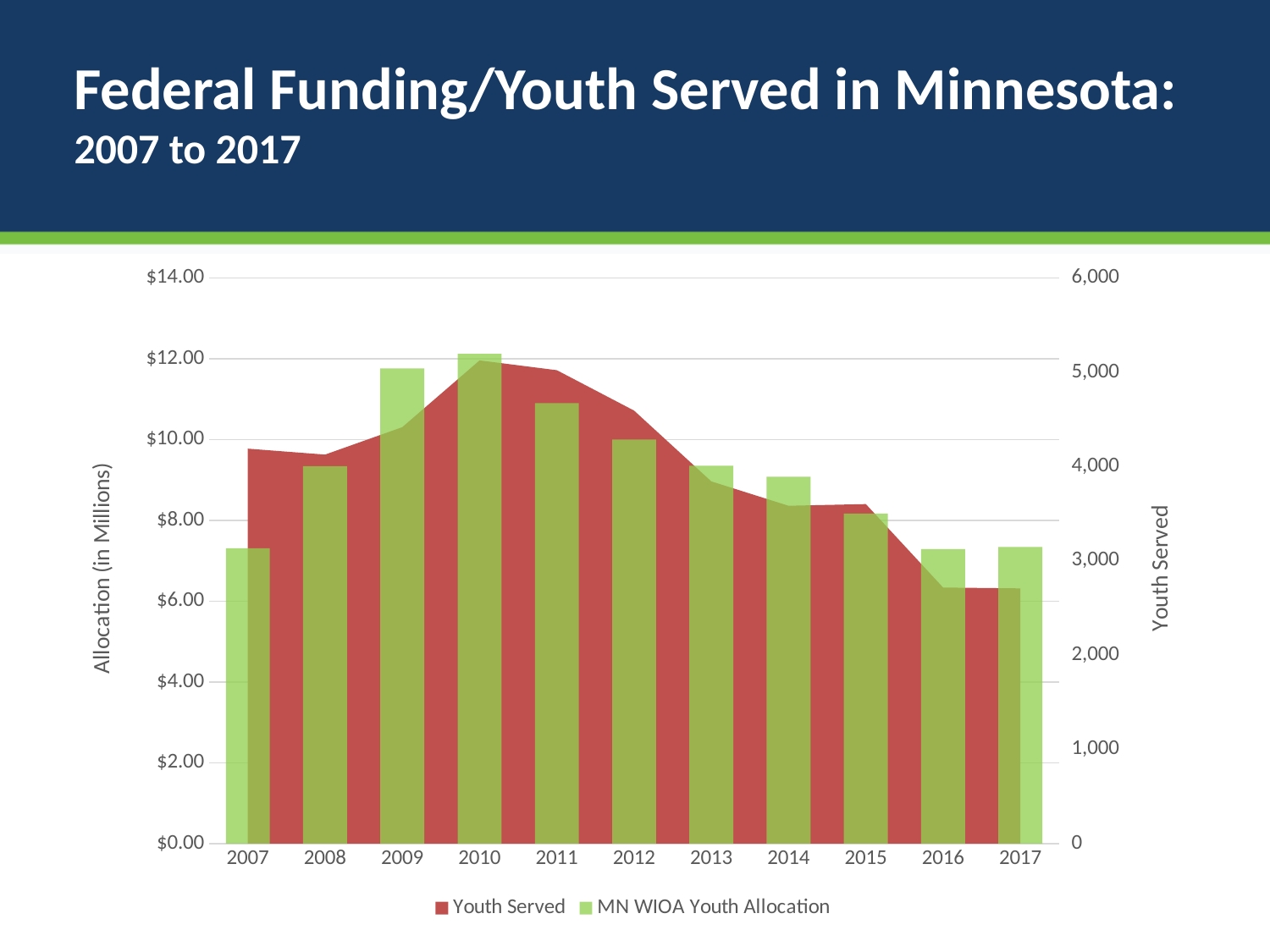
How many years are shown along the x axis of the chart? 11 Does the number of Youth Served rise or fall from 2010 to 2017? fall What kind of chart is shown on the slide? A combination of a bar chart and an area chart Is the number of Youth Served in 2016 greater or less than 3,000? less How many series does the chart's legend list? 2 Is the MN WIOA Youth Allocation for 2009 greater or less than $10.00? greater Which year has a larger MN WIOA Youth Allocation, 2008 or 2009? 2009 Is the number of Youth Served in 2010 greater or less than 5,000? greater What is the label on the left vertical axis of the chart? Allocation (in Millions) Which year has the highest MN WIOA Youth Allocation? 2010